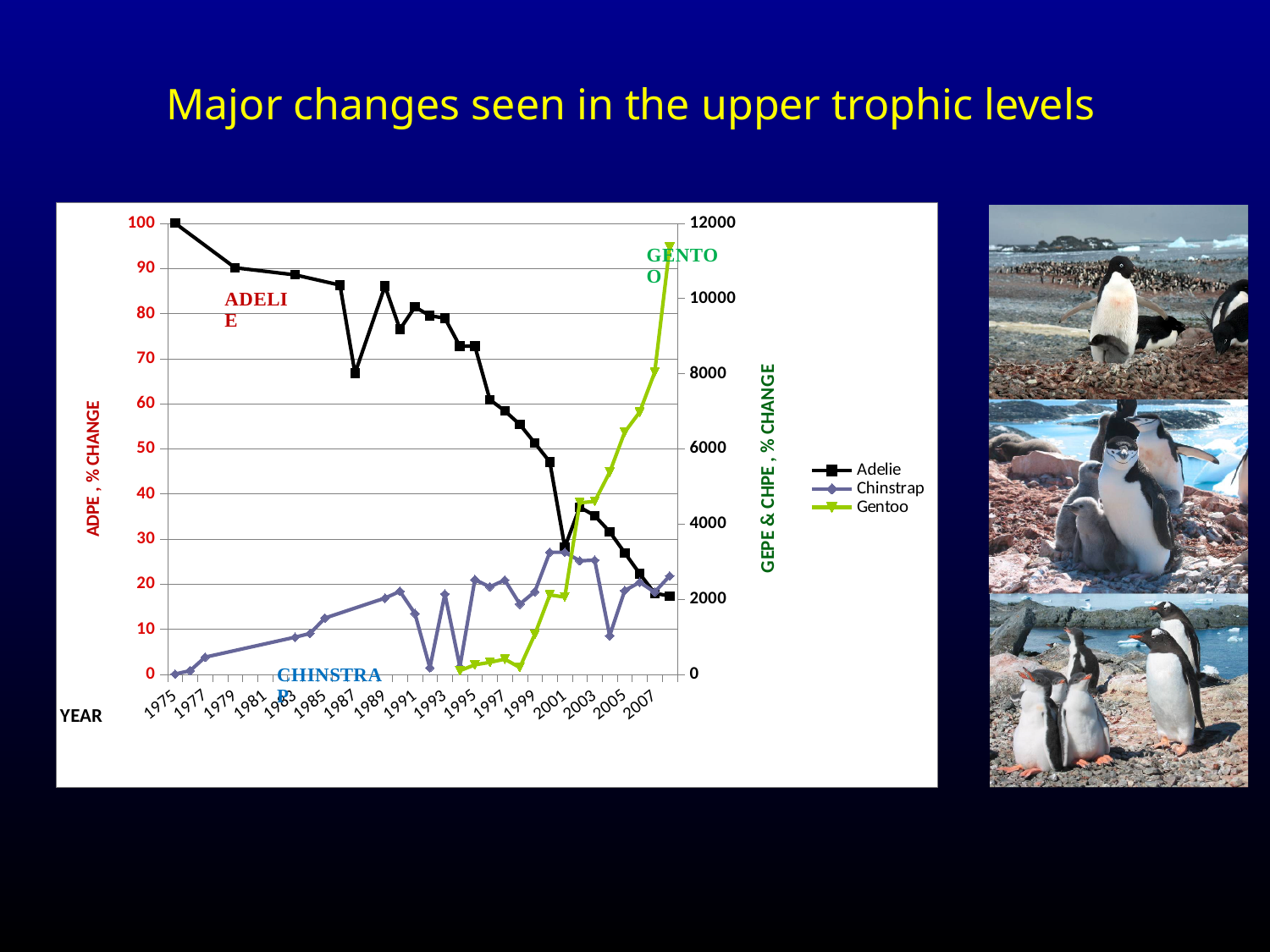
Which series are listed in the legend? Adelie, Chinstrap, Gentoo Is the Gentoo value in 2007 greater or less than 10000? less In which year is the Adelie series at its highest? 1975 What is the Adelie value in 1975? 100 Does the Gentoo series rise or fall from 1995 to 2007? rise What kind of chart is shown on the slide? line chart What is the label of the left vertical axis? ADPE , % CHANGE At 2007, which series is higher on the right-hand axis, Gentoo or Chinstrap? Gentoo Does the Adelie series generally rise or fall from 1975 to 2007? fall How many series does the legend list? 3 Is the Adelie value in 2001 greater or less than 40? less